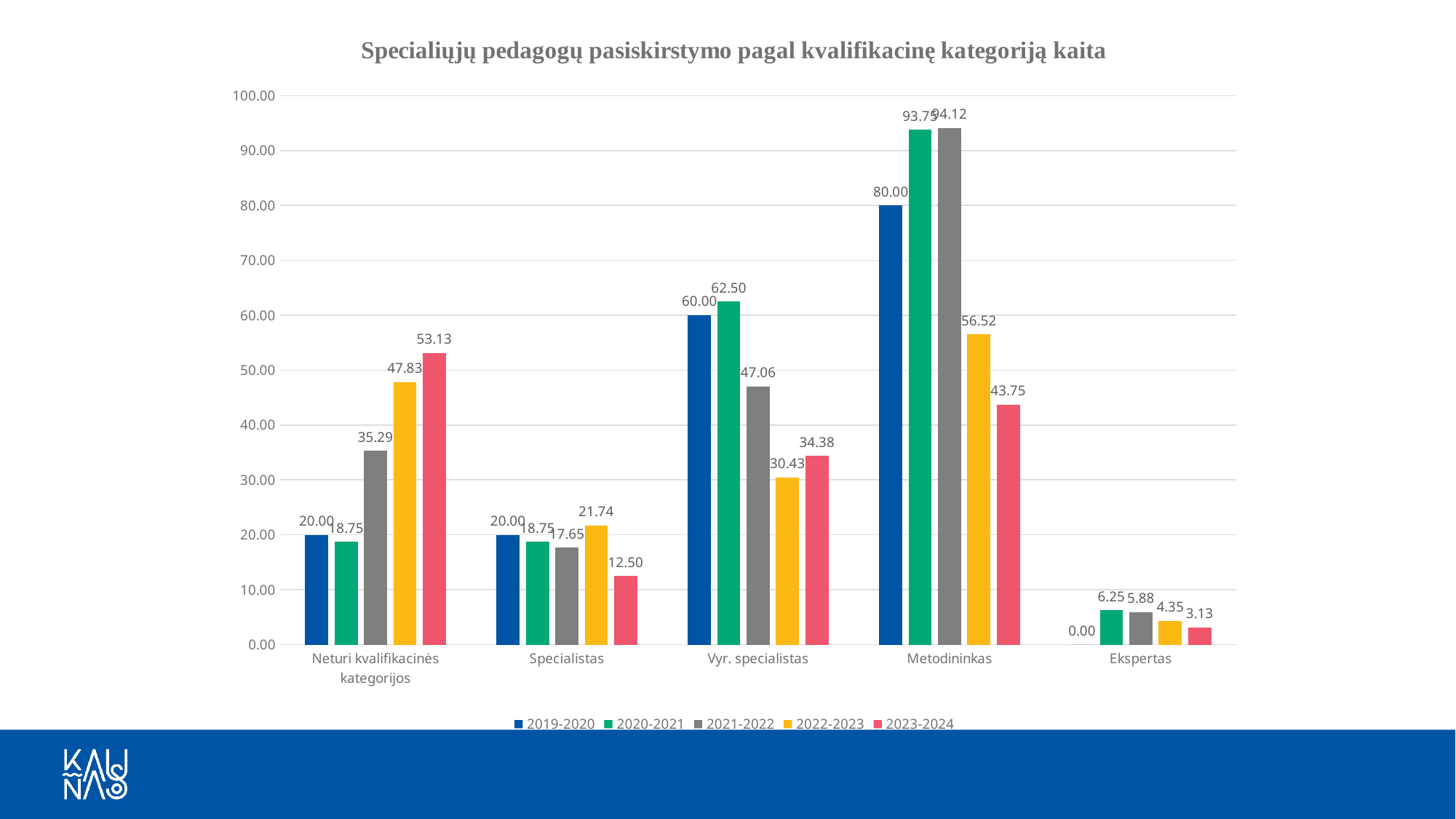
What is the value for Ekspertas in the 2019-2020 series? 0.00 What kind of chart is shown on the slide? Bar chart Which category has the highest value in the 2021-2022 series? Metodininkas Which category has the lowest value in the 2023-2024 series? Ekspertas How many categories are shown on the x axis? 5 What is the value for Metodininkas in the 2019-2020 series? 80.00 How many series does the legend list? 5 What is the difference between the 2019-2020 and 2023-2024 values for Metodininkas? 36.25 What is the value for Neturi kvalifikacinės kategorijos in the 2023-2024 series? 53.13 Across the series from 2019-2020 to 2023-2024, do the values for Neturi kvalifikacinės kategorijos generally rise or fall? Rise Which is larger for Vyr. specialistas: the 2020-2021 value or the 2021-2022 value? 2020-2021 What is the value for Vyr. specialistas in the 2022-2023 series? 30.43